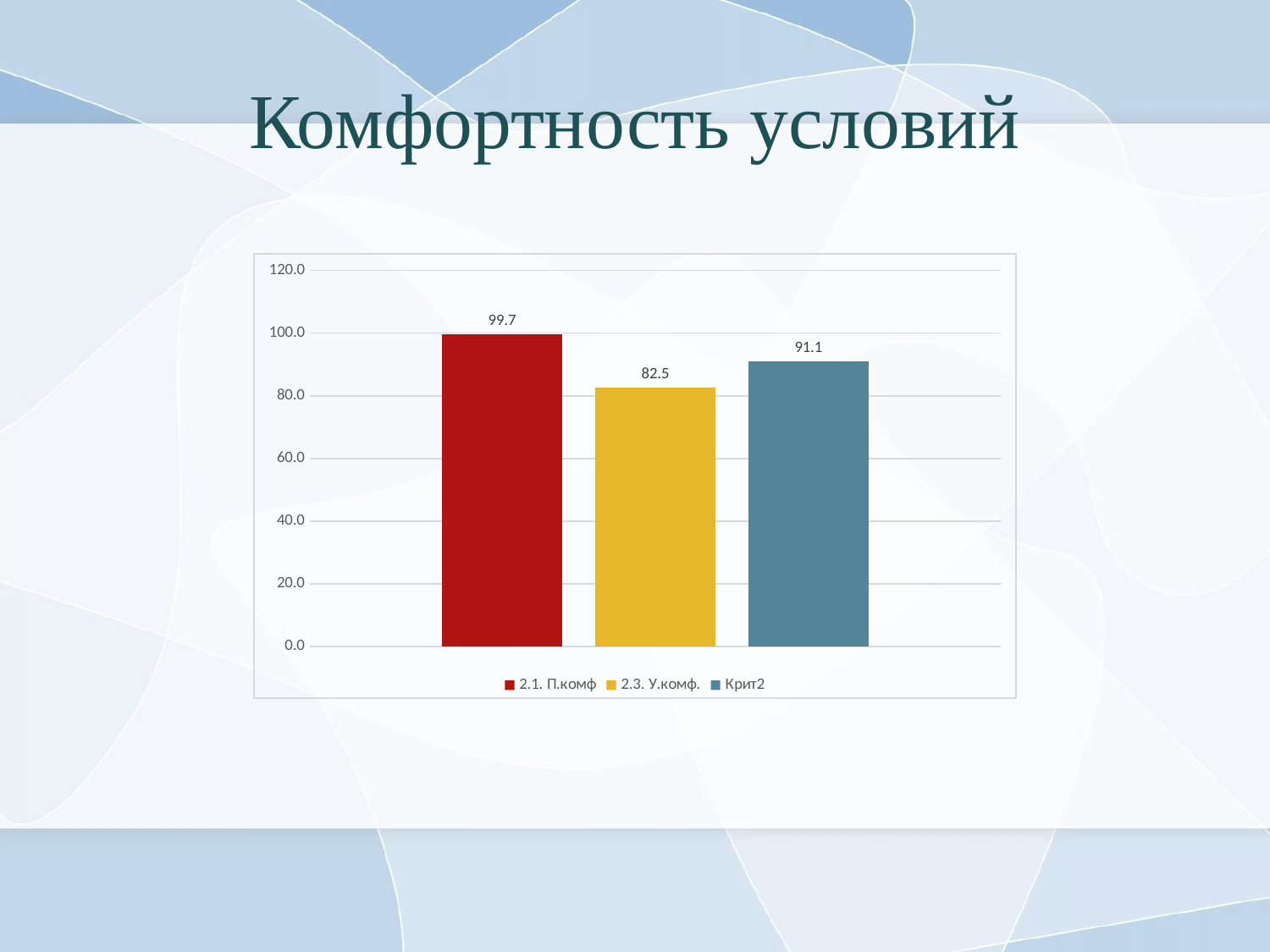
What is the value for Крит2? 91.1 Is the value for Крит2 greater or less than 100.0? less What is the value for 2.1. П.комф? 99.7 Which is larger, the value for Крит2 or the value for 2.3. У.комф.? Крит2 What is the value for 2.3. У.комф.? 82.5 How many series does the legend list? 3 What is the difference between the values for Крит2 and 2.3. У.комф.? 8.6 What kind of chart is shown on the slide? bar chart What is the difference between the values for 2.1. П.комф and 2.3. У.комф.? 17.2 Which series has the highest value? 2.1. П.комф Which series has the lowest value? 2.3. У.комф. What is the title of the slide? Комфортность условий